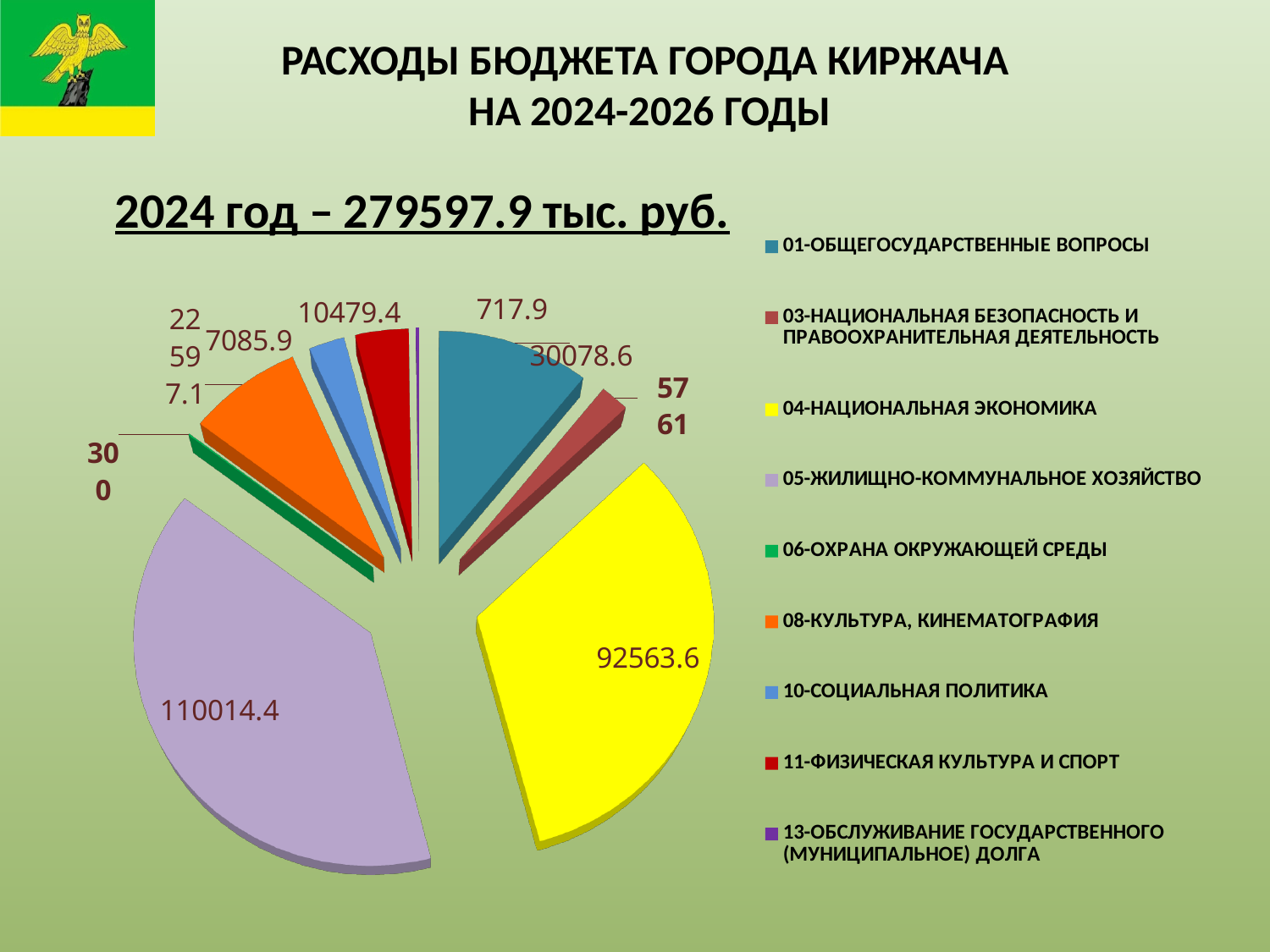
What is the value for 11-ФИЗИЧЕСКАЯ КУЛЬТУРА И СПОРТ? 10479.4 What is the value for 01-ОБЩЕГОСУДАРСТВЕННЫЕ ВОПРОСЫ? 30078.6 What kind of chart is shown on the slide? pie chart What is the value for 10-СОЦИАЛЬНАЯ ПОЛИТИКА? 7085.9 What is the difference between the values for 05-ЖИЛИЩНО-КОММУНАЛЬНОЕ ХОЗЯЙСТВО and 04-НАЦИОНАЛЬНАЯ ЭКОНОМИКА? 17450.8 What total amount for 2024 is stated above the chart? 279597.9 тыс. руб. Which category has the largest slice of the pie? 05-ЖИЛИЩНО-КОММУНАЛЬНОЕ ХОЗЯЙСТВО What colour is the slice for 04-НАЦИОНАЛЬНАЯ ЭКОНОМИКА? yellow Which is larger, the value for 04-НАЦИОНАЛЬНАЯ ЭКОНОМИКА or for 01-ОБЩЕГОСУДАРСТВЕННЫЕ ВОПРОСЫ? 04-НАЦИОНАЛЬНАЯ ЭКОНОМИКА How many categories does the legend list? 9 What is the value for 05-ЖИЛИЩНО-КОММУНАЛЬНОЕ ХОЗЯЙСТВО? 110014.4 What is the value for 04-НАЦИОНАЛЬНАЯ ЭКОНОМИКА? 92563.6